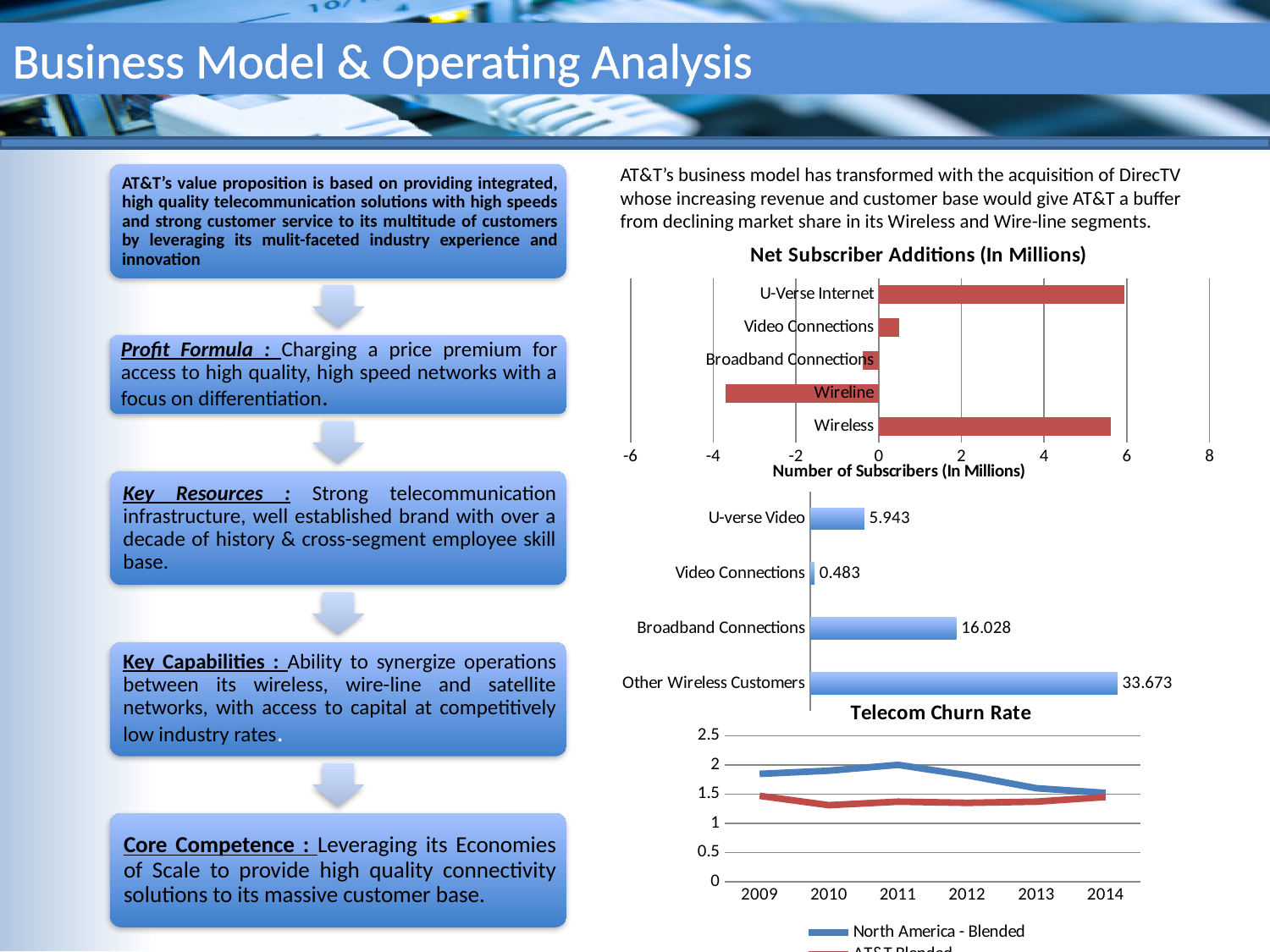
What type of chart is 'Telecom Churn Rate'? line chart In the middle bar chart on the right (the one with data labels), what is the value for Broadband Connections? 16.028 In the middle bar chart on the right (the one with data labels), what is the difference between Other Wireless Customers and Broadband Connections? 17.645 In the 'Net Subscriber Additions (In Millions)' chart, is the value for U-Verse Internet greater or less than 4? greater In the 'Telecom Churn Rate' chart, how many years are shown on the x axis? 6 In the 'Telecom Churn Rate' chart, does the North America - Blended line rise or fall from 2011 to 2014? fall In the middle bar chart on the right (the one with data labels), how many categories are shown? 4 In the 'Net Subscriber Additions (In Millions)' chart, is the value for Wireline greater or less than -2? less In the 'Net Subscriber Additions (In Millions)' chart, how many categories are plotted? 5 In the 'Net Subscriber Additions (In Millions)' chart, which category has the lowest value? Wireline In the middle bar chart on the right (the one with data labels), what is the value for Other Wireless Customers? 33.673 In the middle bar chart on the right (the one with data labels), which category has the lowest value? Video Connections